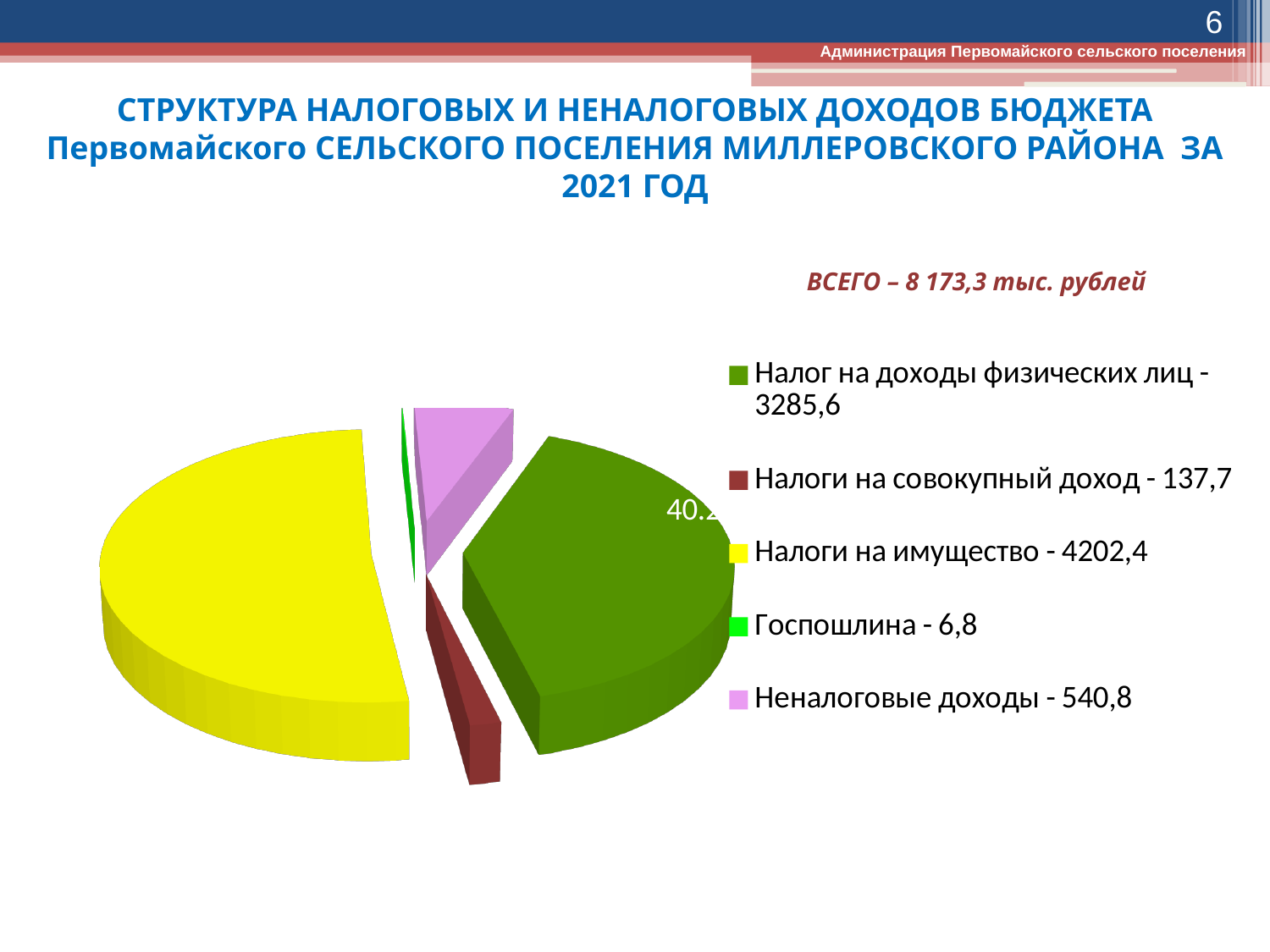
What is the difference between the values for Налоги на имущество and Налог на доходы физических лиц? 916,8 What is the value for Неналоговые доходы? 540,8 What total amount (ВСЕГО) is stated on the slide for the pie chart? 8 173,3 тыс. рублей What colour is the slice for Налоги на имущество? yellow How many categories does the pie chart's legend list? 5 Which category has the largest value in the pie chart? Налоги на имущество What is the value for Налог на доходы физических лиц? 3285,6 Which is larger: Налоги на совокупный доход or Неналоговые доходы? Неналоговые доходы What is the value for Госпошлина? 6,8 Which category has the smallest value in the pie chart? Госпошлина What kind of chart is shown on the slide? pie chart What is the value for Налоги на имущество? 4202,4